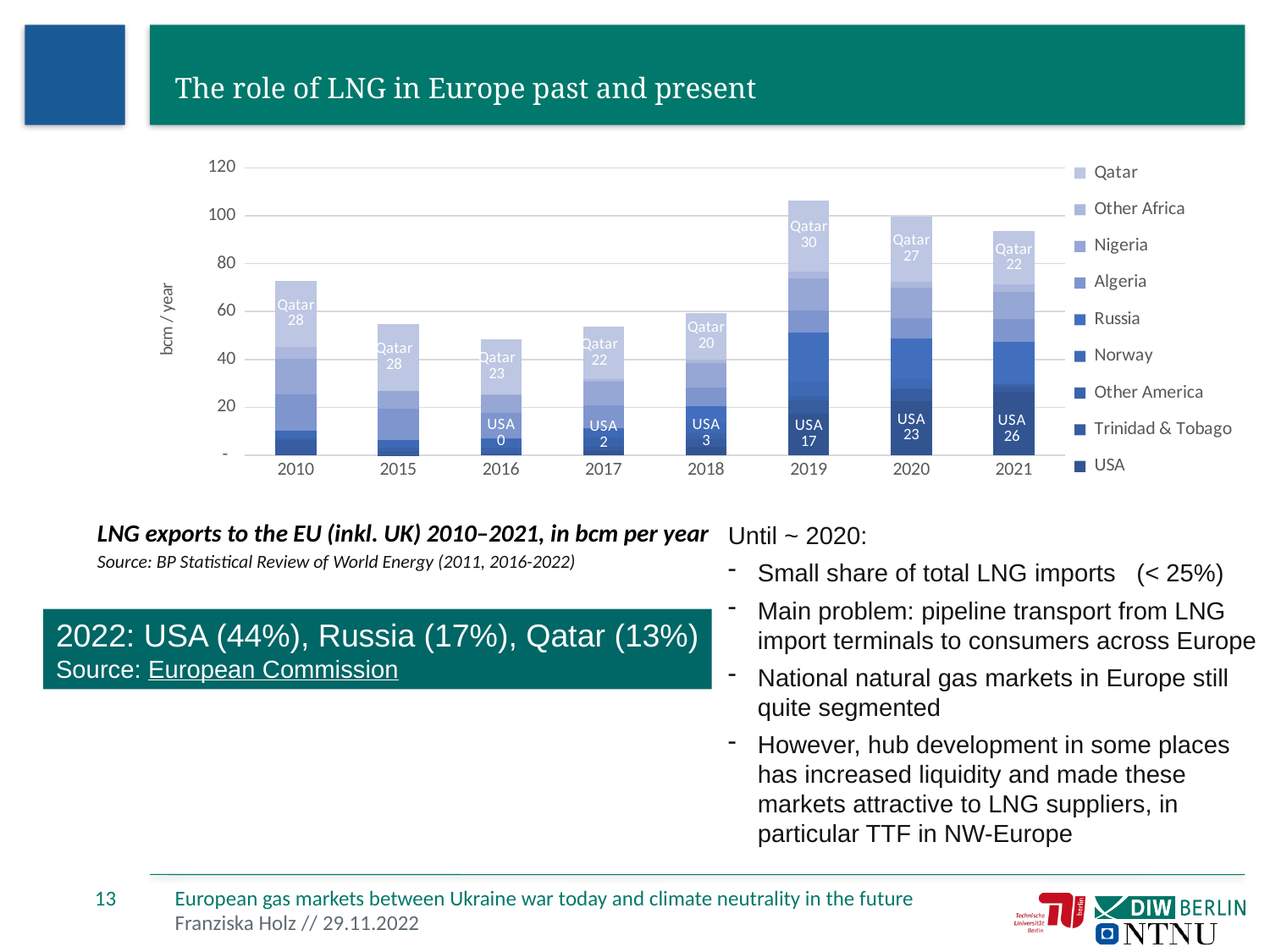
What is the label on the y axis of the chart? bcm / year What is the value for Qatar in 2019? 30 Among the years with a USA label, in which year is the USA value lowest? 2016 How many years are shown on the x axis? 8 What kind of chart is shown on the slide? stacked bar chart In which year is the Qatar value highest? 2019 What is the value for USA in 2021? 26 What is the difference between the Qatar value in 2019 and the Qatar value in 2021? 8 Is the total height of the 2019 bar greater or less than 100? greater Do the USA values rise or fall from 2016 to 2021? rise How many series does the legend list? 9 In 2020, which is larger: the USA value or the Qatar value? Qatar